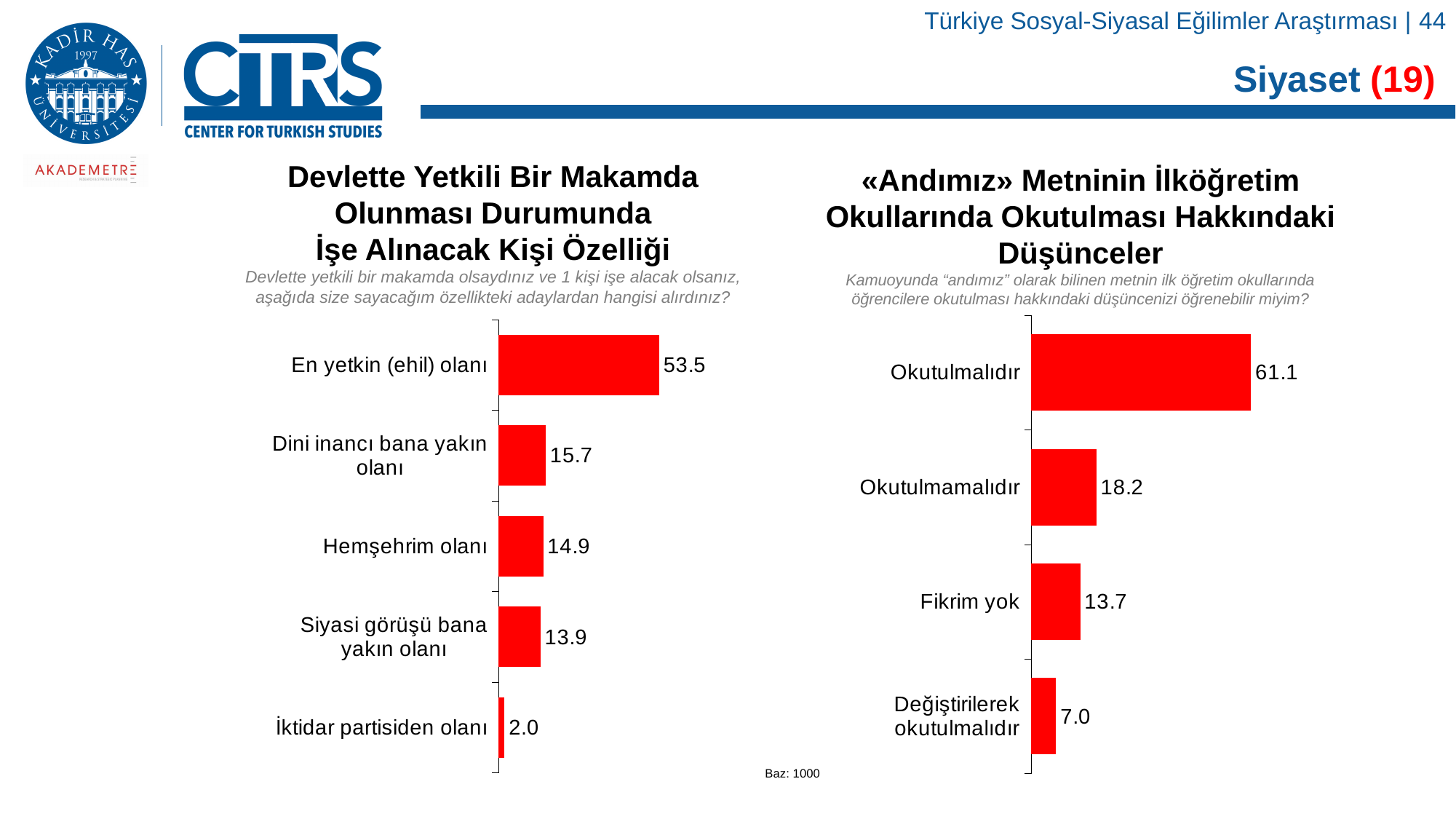
In the left chart, what is the difference between 'Dini inancı bana yakın olanı' and 'Siyasi görüşü bana yakın olanı'? 1.8 In the left chart, what is the value for 'Hemşehrim olanı'? 14.9 In the right chart, what is the difference between 'Okutulmalıdır' and 'Okutulmamalıdır'? 42.9 In the right chart, what is the value for 'Değiştirilerek okutulmalıdır'? 7.0 In the right chart, which category has the highest value? Okutulmalıdır In the left chart, which category has the lowest value? İktidar partisiden olanı What is the base (Baz) sample size shown on the slide? 1000 In the right chart, which is larger: 'Okutulmamalıdır' or 'Fikrim yok'? Okutulmamalıdır In the left chart (Devlette Yetkili Bir Makamda Olunması Durumunda İşe Alınacak Kişi Özelliği), what is the value for 'En yetkin (ehil) olanı'? 53.5 In the left chart, how many categories are shown? 5 What type of chart is the right chart? Bar chart In the right chart («Andımız» Metninin İlköğretim Okullarında Okutulması Hakkındaki Düşünceler), what is the value for 'Okutulmalıdır'? 61.1